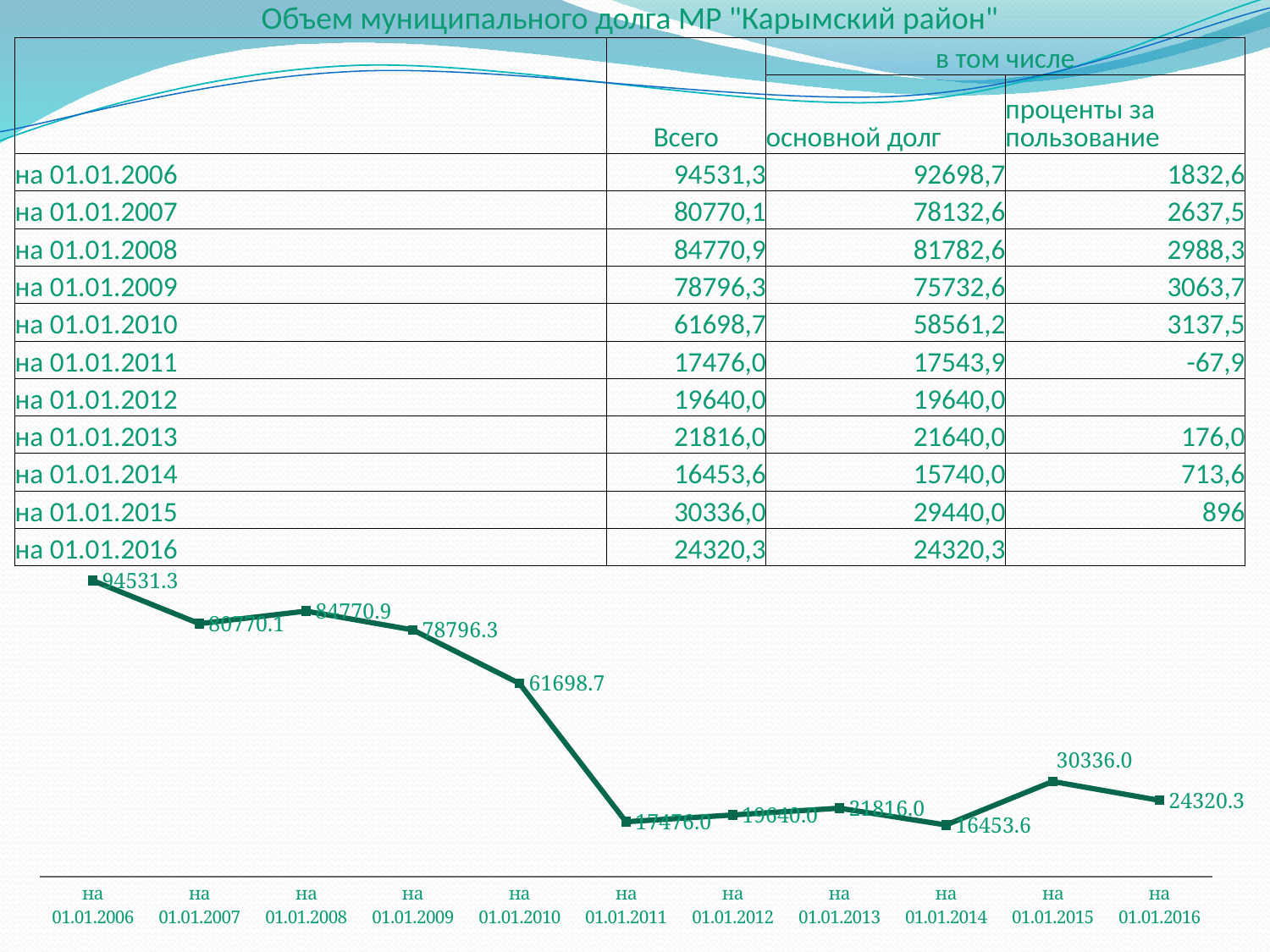
On the line chart, what is the difference between the values for на 01.01.2006 and на 01.01.2016? 70211.0 On the line chart, what is the difference between the values for на 01.01.2015 and на 01.01.2014? 13882.4 How many data points are plotted on the line chart? 11 What is the value plotted on the line chart for на 01.01.2010? 61698.7 What is the value plotted on the line chart for на 01.01.2016? 24320.3 What kind of chart is shown at the bottom of the slide? line chart On the line chart, which is larger: the value for на 01.01.2008 or the value for на 01.01.2009? на 01.01.2008 Which date has the highest value on the line chart? на 01.01.2006 Which date has the lowest value on the line chart? на 01.01.2014 Do the values on the line chart generally rise or fall from на 01.01.2006 to на 01.01.2016? fall What is the value plotted on the line chart for на 01.01.2006? 94531.3 What is the value plotted on the line chart for на 01.01.2015? 30336.0